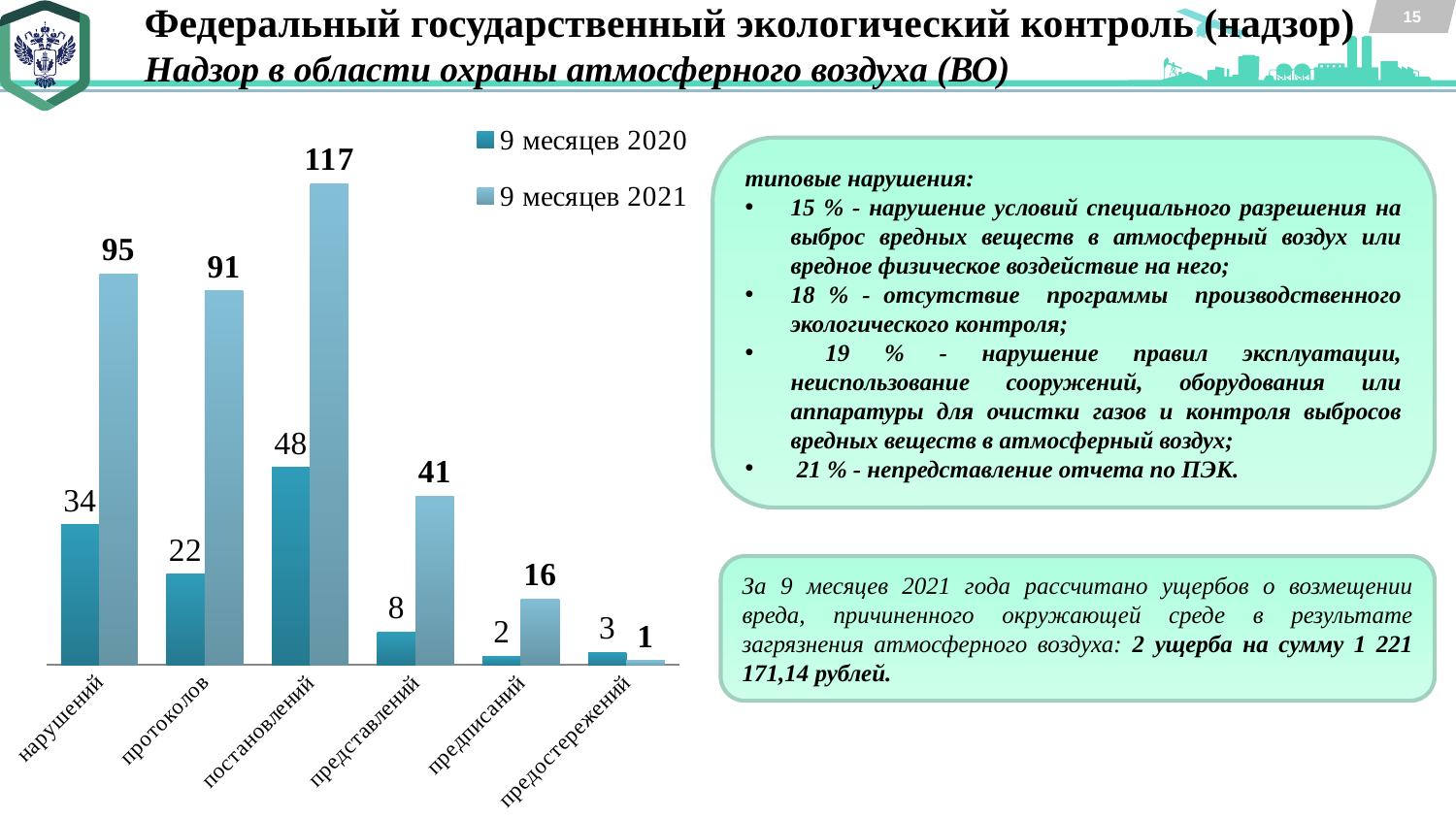
What kind of chart is shown on the slide? bar chart What is the difference between the 9 месяцев 2021 and 9 месяцев 2020 values for протоколов? 69 What is the value for нарушений in the 9 месяцев 2020 series? 34 What is the difference between the 9 месяцев 2021 and 9 месяцев 2020 values for представлений? 33 For предостережений, which series has the larger value, 9 месяцев 2020 or 9 месяцев 2021? 9 месяцев 2020 Which is larger: the 9 месяцев 2021 value for нарушений or the 9 месяцев 2021 value for протоколов? нарушений What is the value for предписаний in the 9 месяцев 2021 series? 16 What is the value for постановлений in the 9 месяцев 2021 series? 117 How many categories are shown on the x axis of the chart? 6 Which category has the lowest value in the 9 месяцев 2020 series? предписаний How many series does the chart legend list? 2 Which category has the highest value in the 9 месяцев 2021 series? постановлений